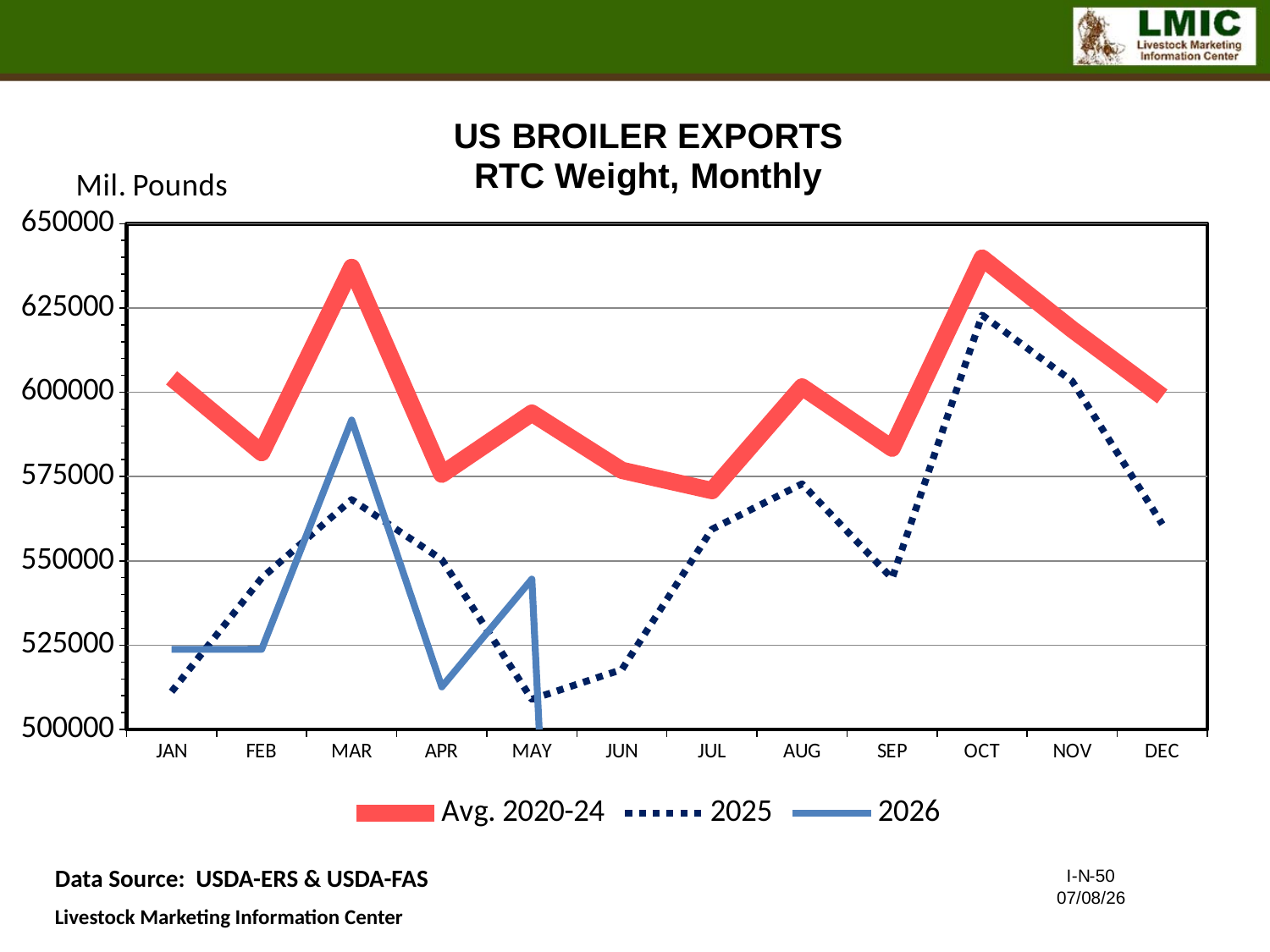
Does the 2025 series rise or fall from OCT to DEC? fall Is the Avg. 2020-24 value for MAR greater or less than 625000? greater In which month does the 2025 series reach its highest value? OCT In OCT, which series has the larger value, Avg. 2020-24 or 2025? Avg. 2020-24 What kind of chart is shown on the slide? line chart In which month does the 2026 series reach its highest value? MAR Is the 2026 value for APR greater or less than 525000? less How many months are shown along the x axis? 12 In MAR, which series has the larger value, 2025 or 2026? 2026 How many series does the legend list? 3 Is the 2025 value for DEC greater or less than 550000? greater